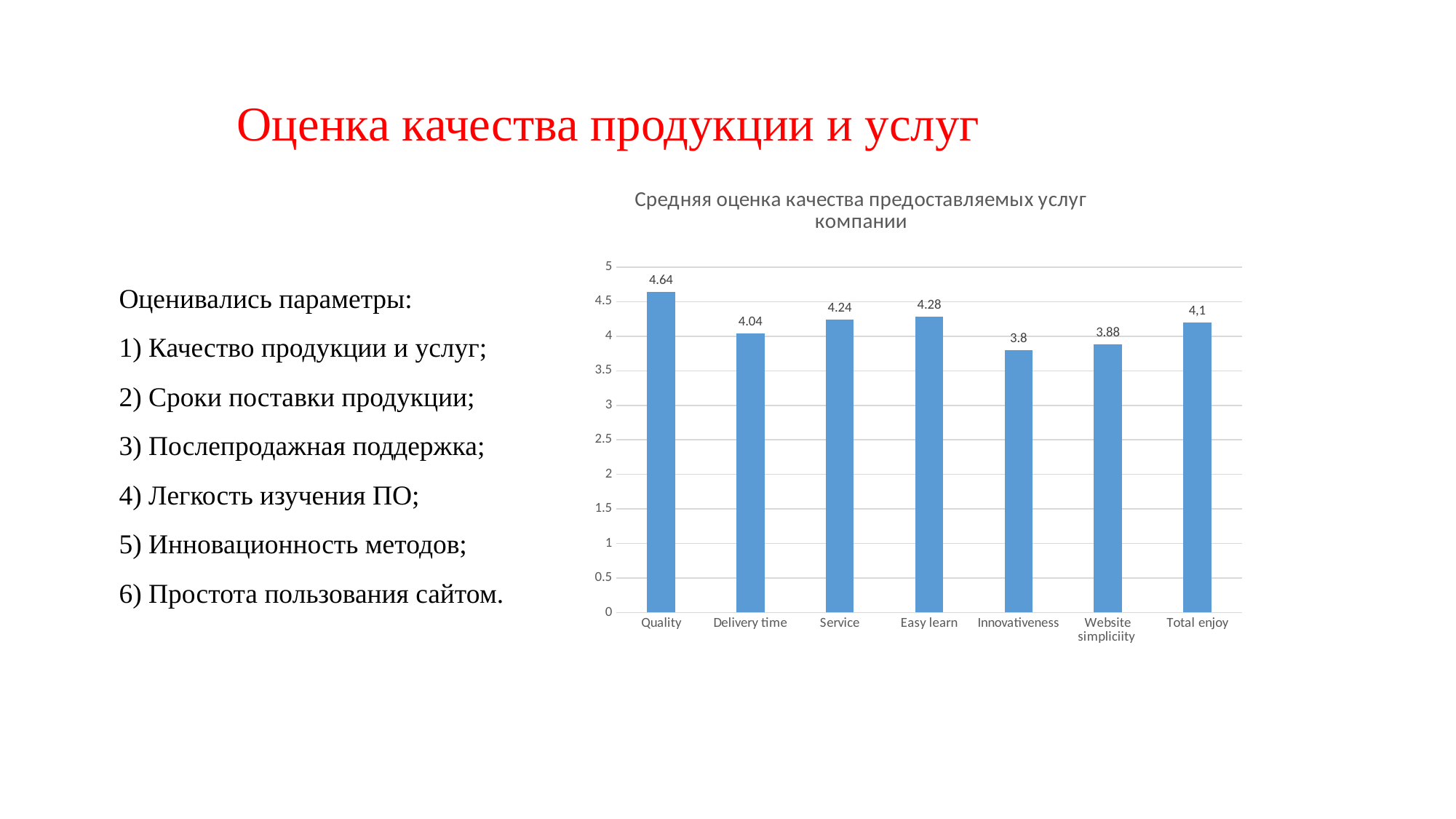
What kind of chart is shown on the slide? Bar chart Which category has the highest value? Quality What is the value for Quality? 4.64 What is the value for Total enjoy? 4,1 Is the value for Easy learn greater or less than 4? greater Which is larger, the value for Service or the value for Website simpliciity? Service What is the difference between the values for Quality and Delivery time? 0.6 What is the value for Innovativeness? 3.8 What is the title of the chart? Средняя оценка качества предоставляемых услуг компании What is the difference between the values for Website simpliciity and Innovativeness? 0.08 How many categories are shown on the x axis? 7 Which category has the lowest value? Innovativeness